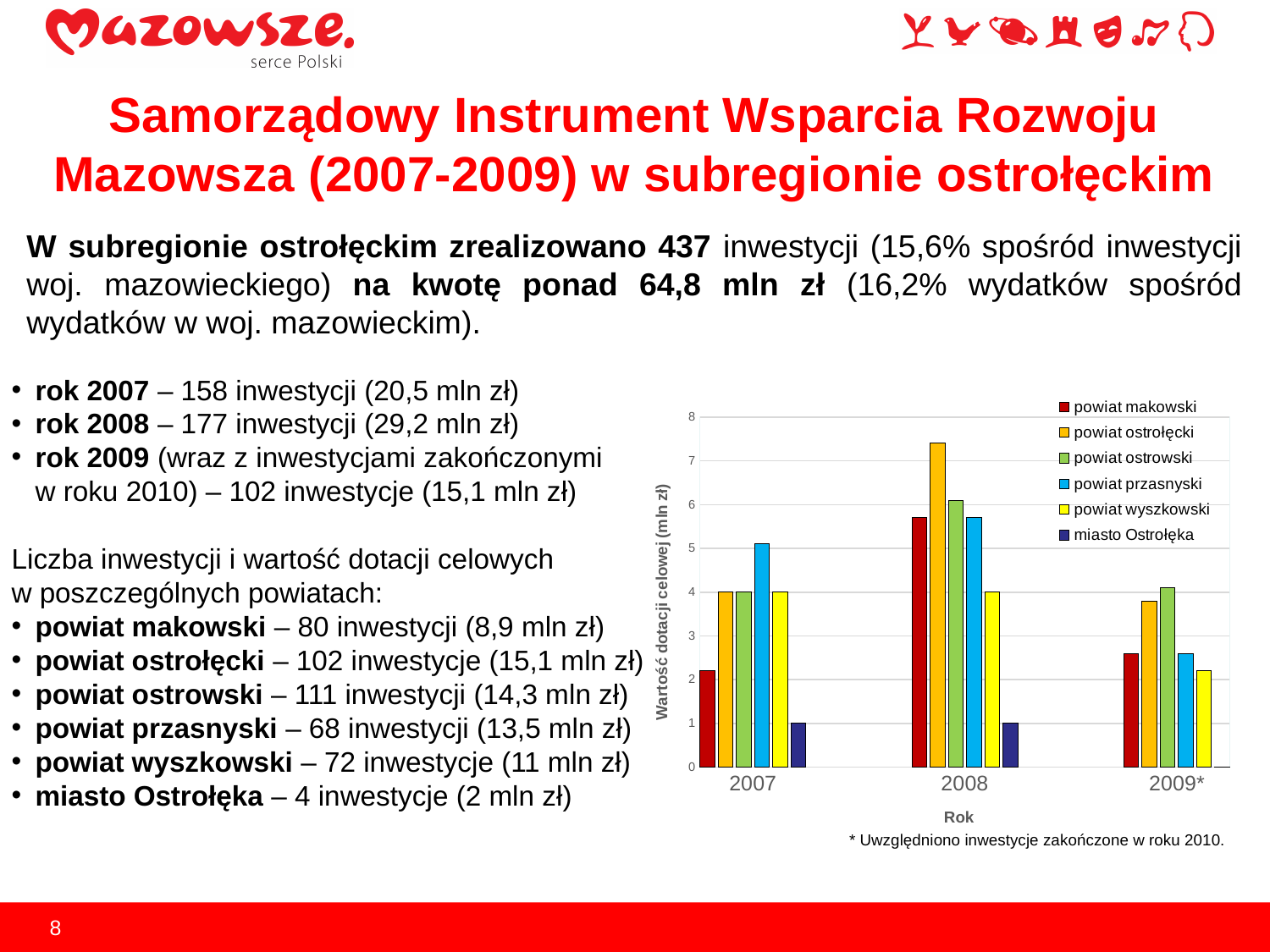
How many year categories are shown on the x axis of the chart? 3 How many series does the chart legend list? 6 Is the value for powiat ostrołęcki in 2008 greater or less than 7? greater Which series has the tallest bar in the chart overall? powiat ostrołęcki Which is larger in 2009*: the bar for powiat ostrowski or the bar for powiat wyszkowski? powiat ostrowski Which series is shown in dark blue in the chart legend? miasto Ostrołęka Is the value for powiat makowski in 2007 greater or less than 3? less What is the title of the vertical axis of the chart? Wartość dotacji celowej (mln zł) In which year does powiat ostrołęcki have its highest bar? 2008 Which series has the lowest bar in 2008? miasto Ostrołęka What kind of chart is shown on the slide? bar chart